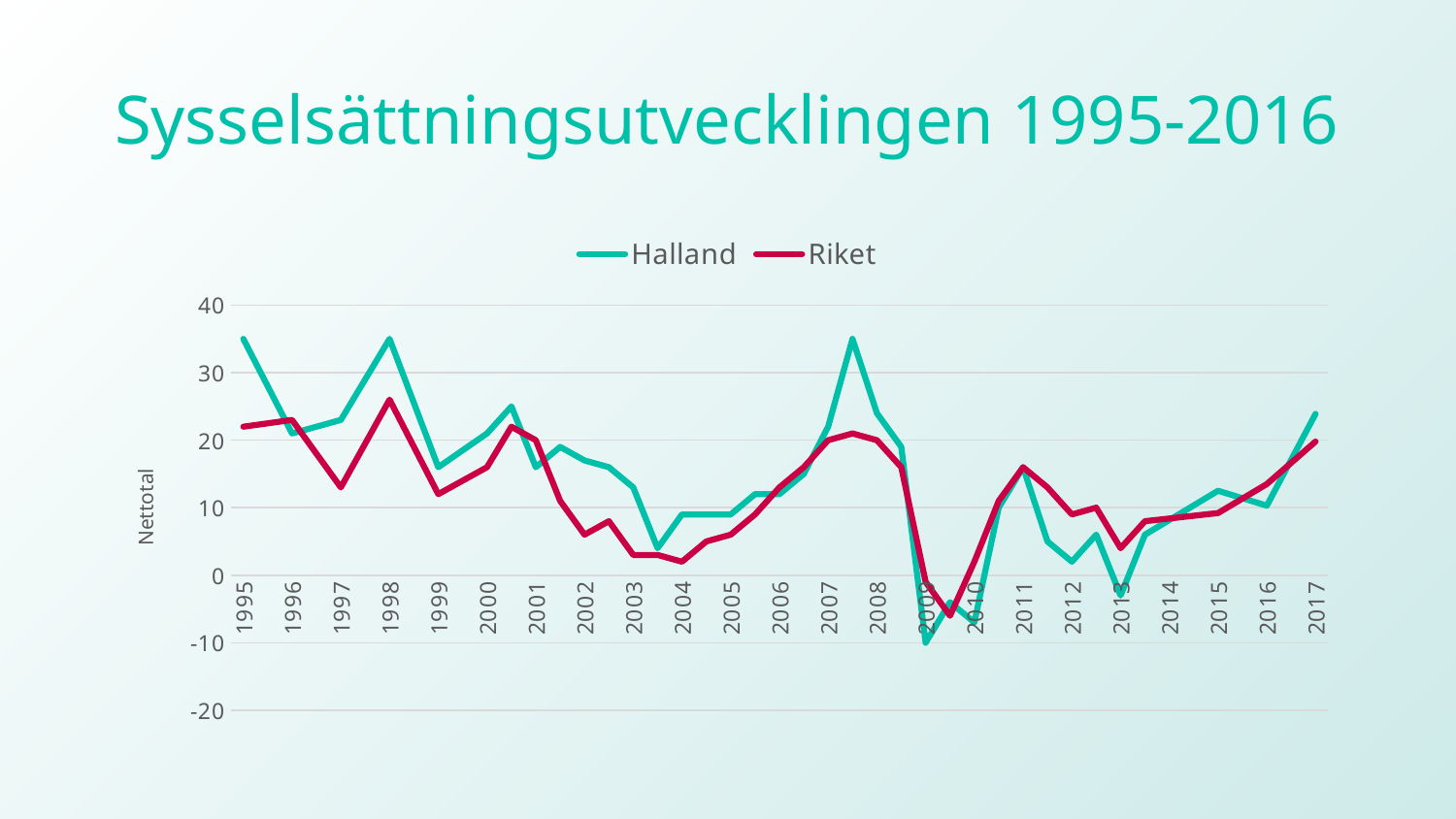
Is the value for Halland in 1995 greater or less than 30? greater Is the value for Riket in 2017 greater or less than 10? greater How many series does the legend list? 2 Is the value for Halland in 2009 greater or less than 0? less In which year does the Halland series reach its lowest value? 2009 In 2016, which series has the higher value, Halland or Riket? Riket What kind of chart is shown on the slide? line chart What are the two series named in the legend? Halland and Riket In 1998, which series has the higher value, Halland or Riket? Halland Does the Halland series rise or fall from 2016 to 2017? rise What is the title of the vertical axis? Nettotal